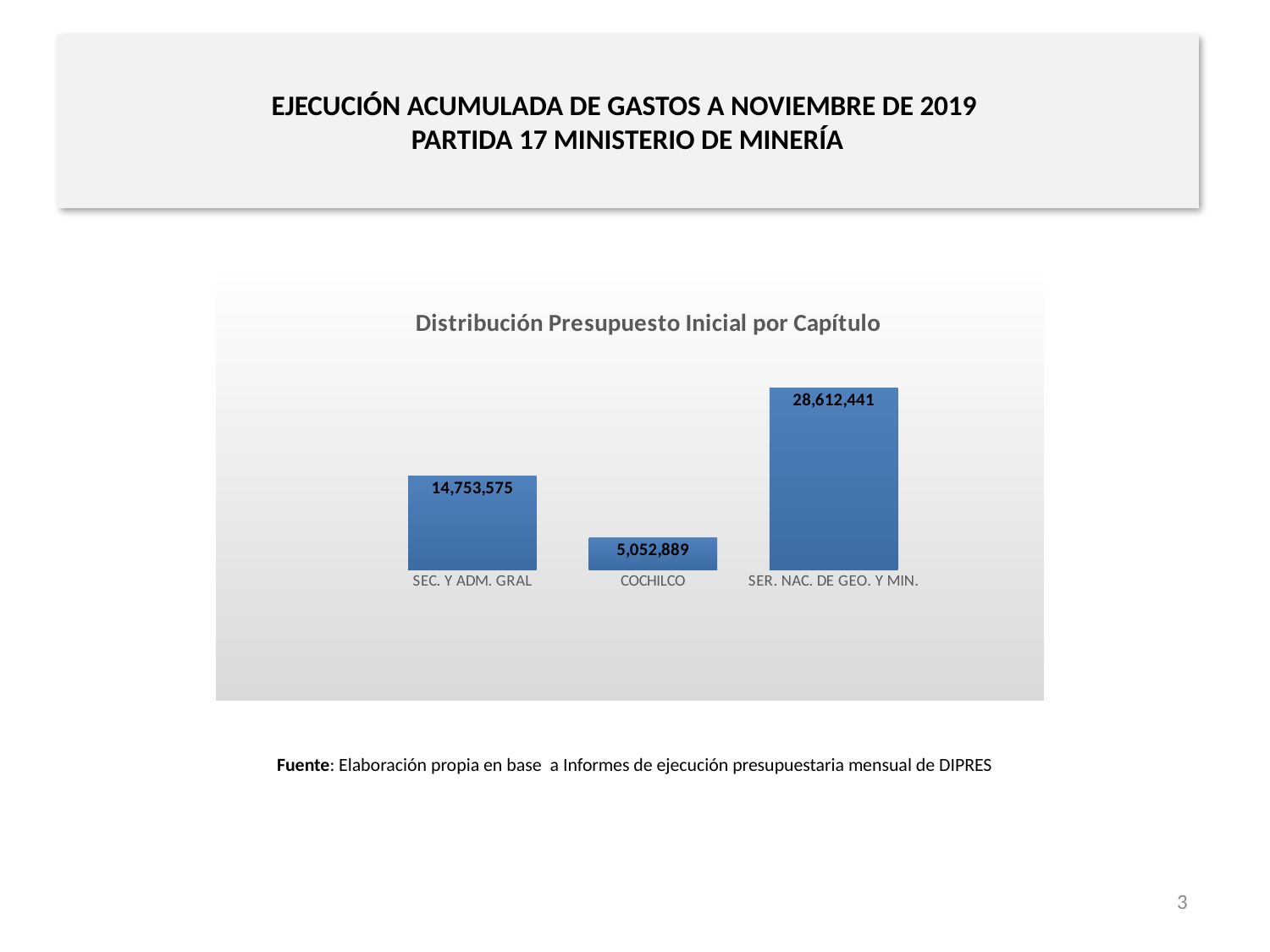
What is the value for SER. NAC. DE GEO. Y MIN.? 28,612,441 What is the value for COCHILCO? 5,052,889 What is the title of the chart? Distribución Presupuesto Inicial por Capítulo How many categories are shown in the chart? 3 Which category has the lowest value? COCHILCO What is the value for SEC. Y ADM. GRAL? 14,753,575 What is the total of the three values shown in the chart? 48,418,905 What kind of chart is shown on the slide? Bar chart Which is larger, the value for SEC. Y ADM. GRAL or the value for COCHILCO? SEC. Y ADM. GRAL Which category has the highest value? SER. NAC. DE GEO. Y MIN. What is the difference between the values for SEC. Y ADM. GRAL and COCHILCO? 9,700,686 What is the difference between the values for SER. NAC. DE GEO. Y MIN. and SEC. Y ADM. GRAL? 13,858,866